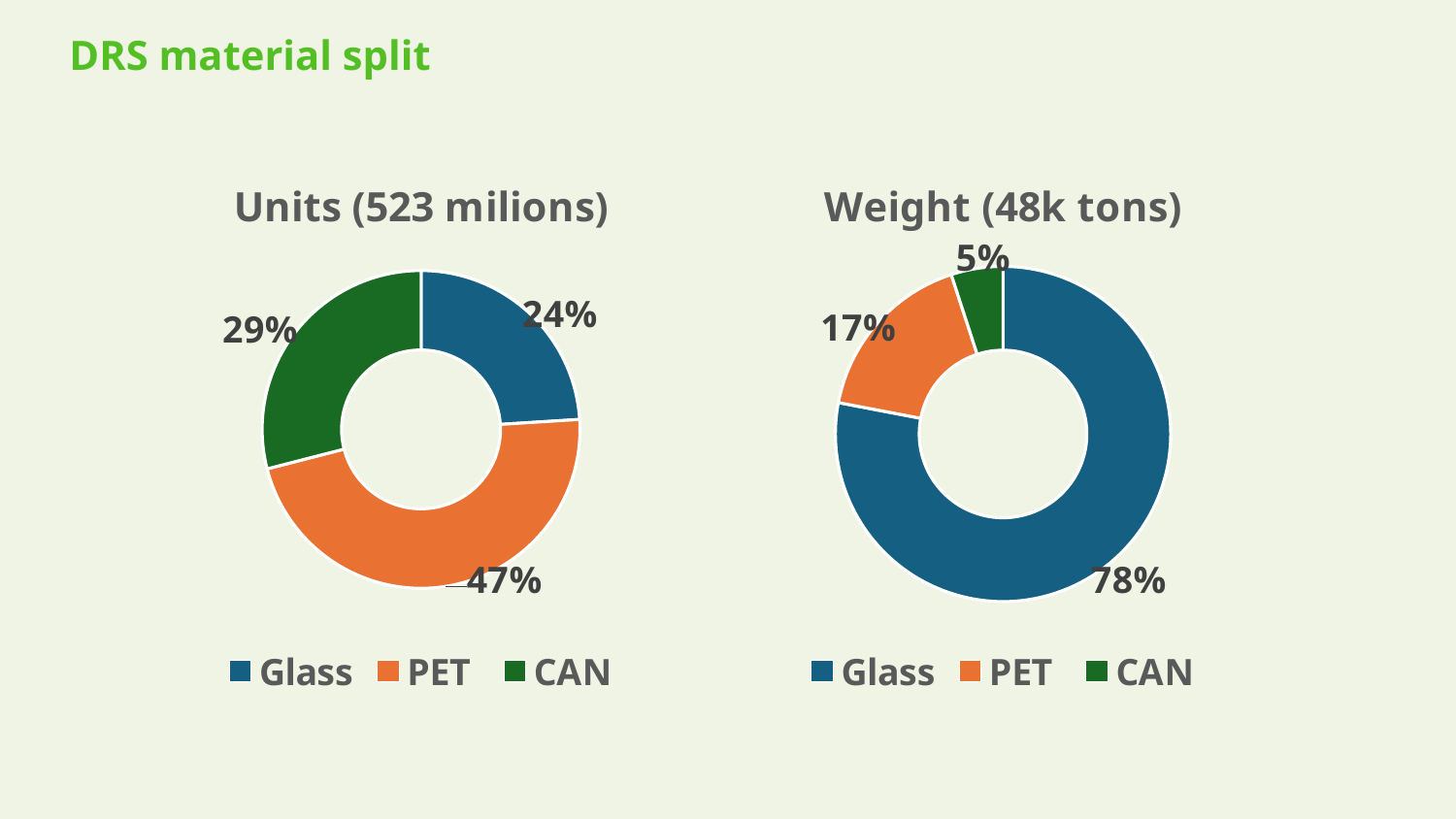
In the 'Weight (48k tons)' chart, what share does CAN have? 5% In the 'Units (523 milions)' chart, what share does PET have? 47% In the 'Units (523 milions)' chart, which material has the smallest share? Glass How many materials are shown in the 'Weight (48k tons)' chart? 3 In the 'Units (523 milions)' chart, which is larger, the share for CAN or the share for Glass? CAN In the 'Units (523 milions)' chart, which material has the largest share? PET In the 'Weight (48k tons)' chart, which material has the smallest share? CAN What kind of chart is the 'Units (523 milions)' chart? Doughnut chart In the 'Weight (48k tons)' chart, which colour represents PET? Orange In the 'Weight (48k tons)' chart, what share does Glass have? 78% In the 'Weight (48k tons)' chart, what is the difference in percentage points between Glass and PET? 61 In the 'Units (523 milions)' chart, what share does Glass have? 24%